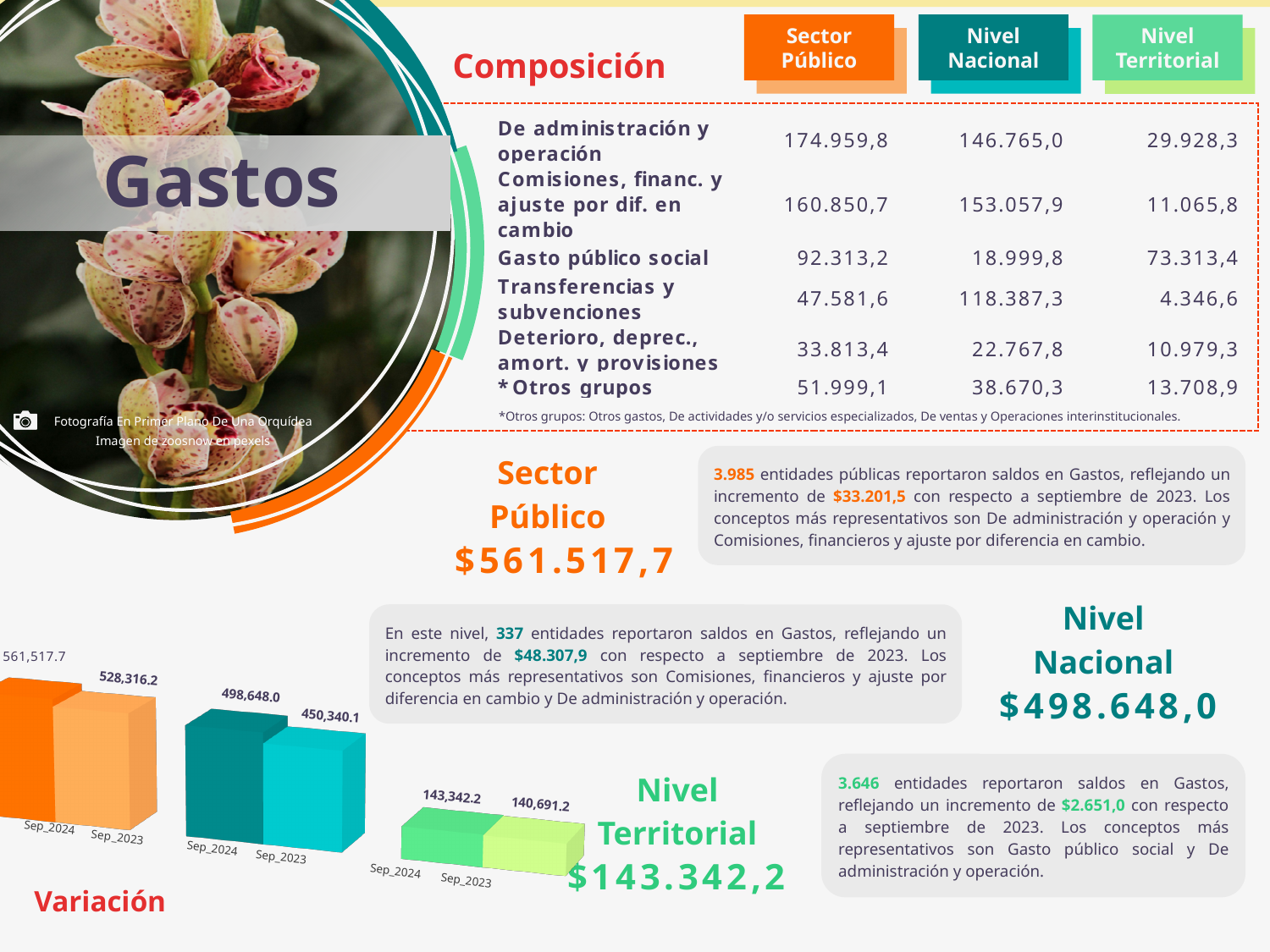
In the teal bar chart in the bottom middle, what is the difference between the Sep_2024 and Sep_2023 values? 48,307.9 How many bars does the orange bar chart at the bottom left show? 2 In the orange bar chart at the bottom left, what is the value for Sep_2023? 528,316.2 In the teal bar chart in the bottom middle, what is the value for Sep_2024? 498,648.0 In the orange bar chart at the bottom left, what is the difference between the Sep_2024 and Sep_2023 values? 33,201.5 In the teal bar chart in the bottom middle, what is the value for Sep_2023? 450,340.1 In the teal bar chart in the bottom middle, which period has the higher value, Sep_2024 or Sep_2023? Sep_2024 In the orange bar chart at the bottom left, what is the value for Sep_2024? 561,517.7 What kind of chart is used in the 'Variación' section at the bottom of the slide? Bar chart In the green bar chart next to the 'Nivel Territorial' heading, what is the value for Sep_2023? 140,691.2 In the green bar chart next to the 'Nivel Territorial' heading, what is the value for Sep_2024? 143,342.2 In the green bar chart next to the 'Nivel Territorial' heading, what is the difference between the Sep_2024 and Sep_2023 values? 2,651.0